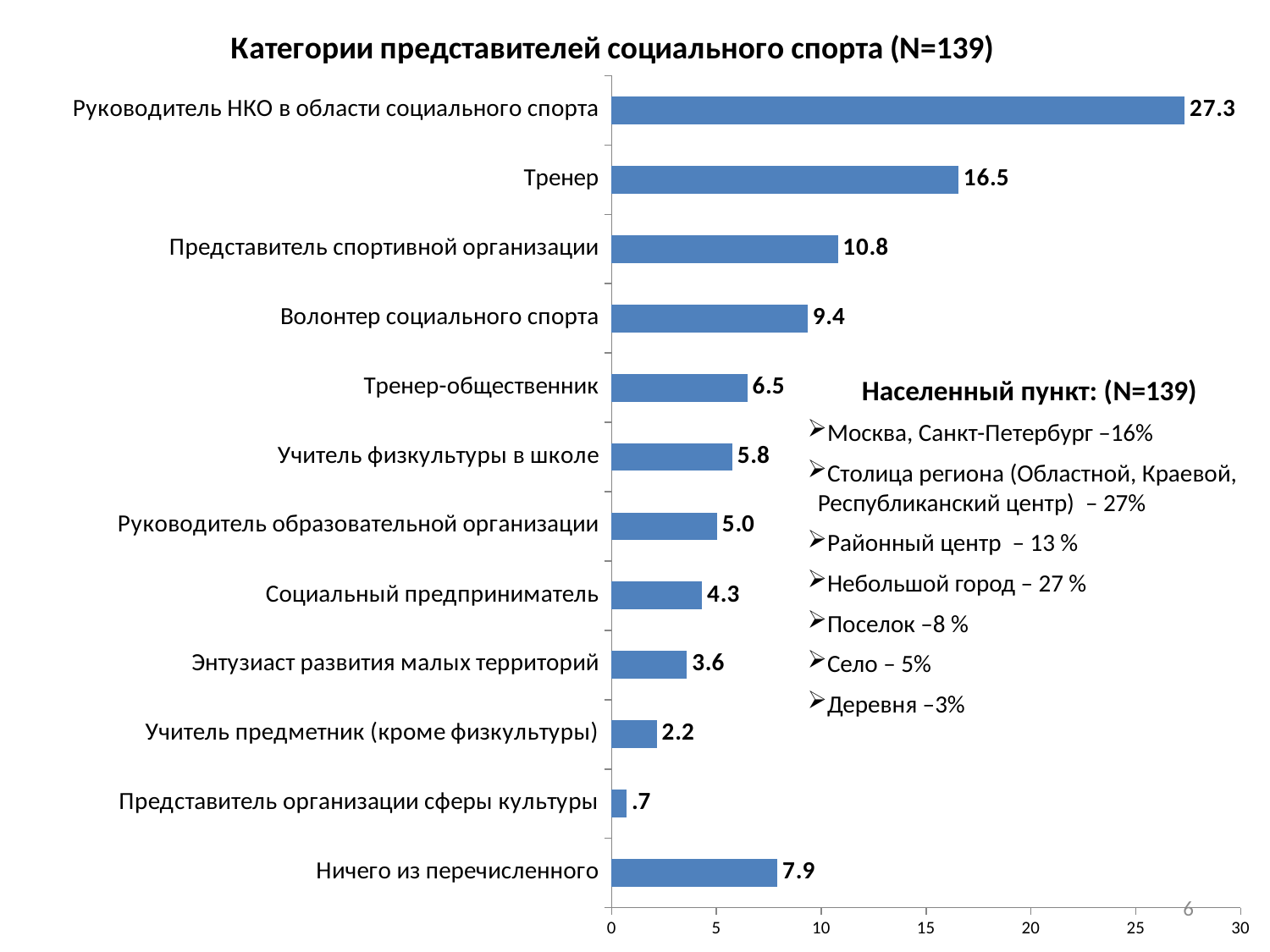
What is the value for Тренер? 16.5 What kind of chart is shown on the slide? bar chart Which category has the lowest value? Представитель организации сферы культуры Which is larger, the value for Социальный предприниматель or the value for Учитель физкультуры в школе? Учитель физкультуры в школе What is the value for Ничего из перечисленного? 7.9 What is the value for Учитель предметник (кроме физкультуры)? 2.2 What is the title of the chart? Категории представителей социального спорта (N=139) What is the difference between the values for Руководитель НКО в области социального спорта and Тренер? 10.8 How many categories are shown in the chart? 12 Which category has the highest value? Руководитель НКО в области социального спорта What is the value for Волонтер социального спорта? 9.4 Is the value for Представитель спортивной организации greater or less than 10? greater